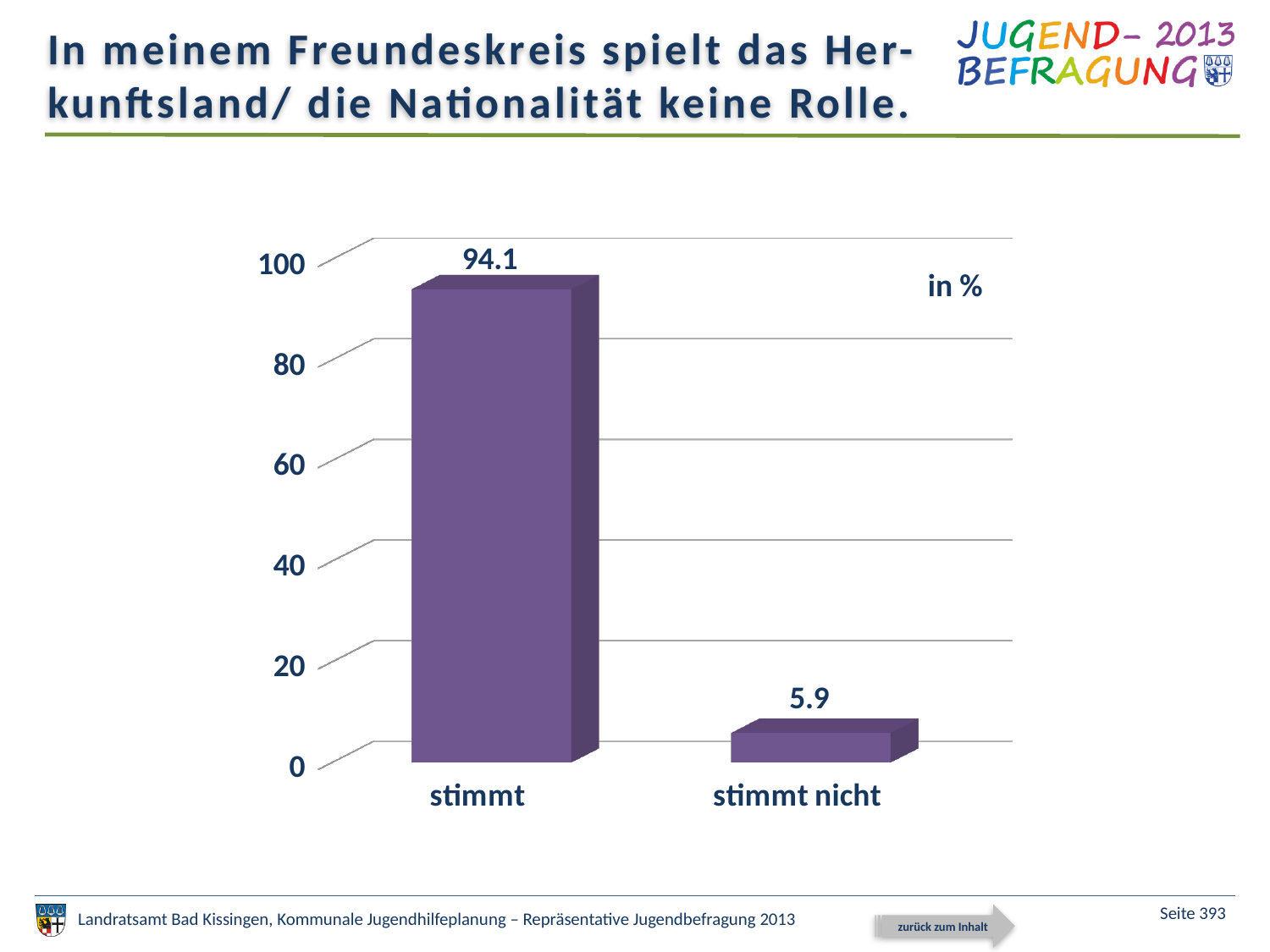
Is the value for "stimmt nicht" greater or less than 20? less Is the value for "stimmt" greater or less than 80? greater What is the value for "stimmt nicht"? 5.9 What kind of chart is shown on the slide? bar chart What is the value for "stimmt"? 94.1 What is the difference between the values for "stimmt" and "stimmt nicht"? 88.2 Which category has the lowest value? stimmt nicht Which is larger, the value for "stimmt" or for "stimmt nicht"? stimmt Which category has the highest value? stimmt In what unit are the values given, according to the label on the chart? in % How many categories are shown on the x axis? 2 What is the total of the two plotted values? 100